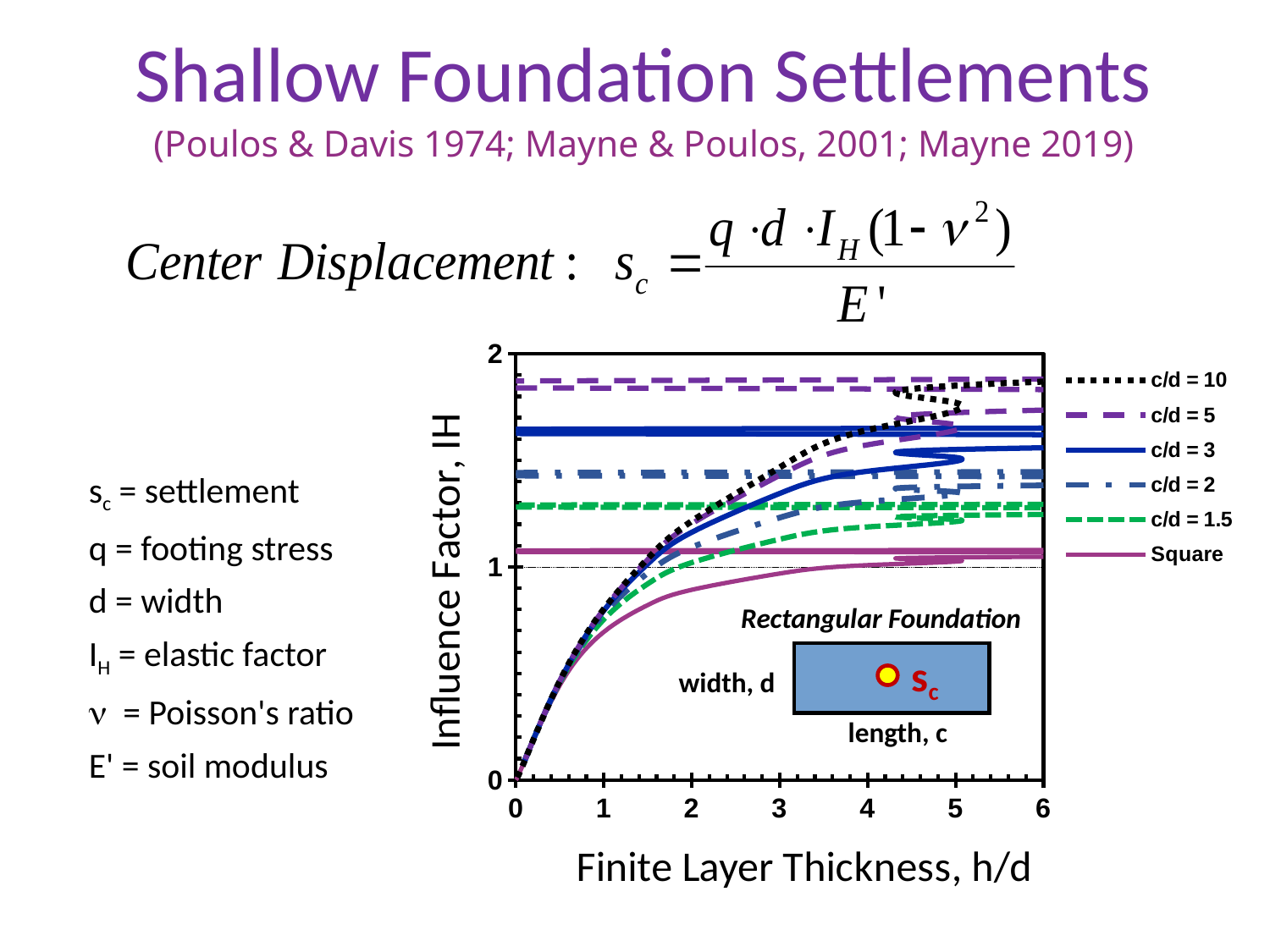
Which series has the lowest influence factor at large layer thickness? Square Is the influence factor for c/d = 10 at h/d = 6 greater or less than 1? greater What is the title of the x axis of the chart? Finite Layer Thickness, h/d At h/d = 6, which is larger: the influence factor for c/d = 10 or for Square? c/d = 10 How many series does the chart legend list? 6 What is the title of the y axis of the chart? Influence Factor, IH Is the influence factor for c/d = 3 at h/d = 6 greater or less than 1? greater At h/d = 6, which is larger: the influence factor for c/d = 5 or for c/d = 1.5? c/d = 5 Do the influence factor curves rise or fall as h/d increases? rise Is the influence factor for Square at h/d = 1 greater or less than 1? less Which series reaches the highest influence factor on the chart? c/d = 10 What kind of chart is shown on the slide? line chart